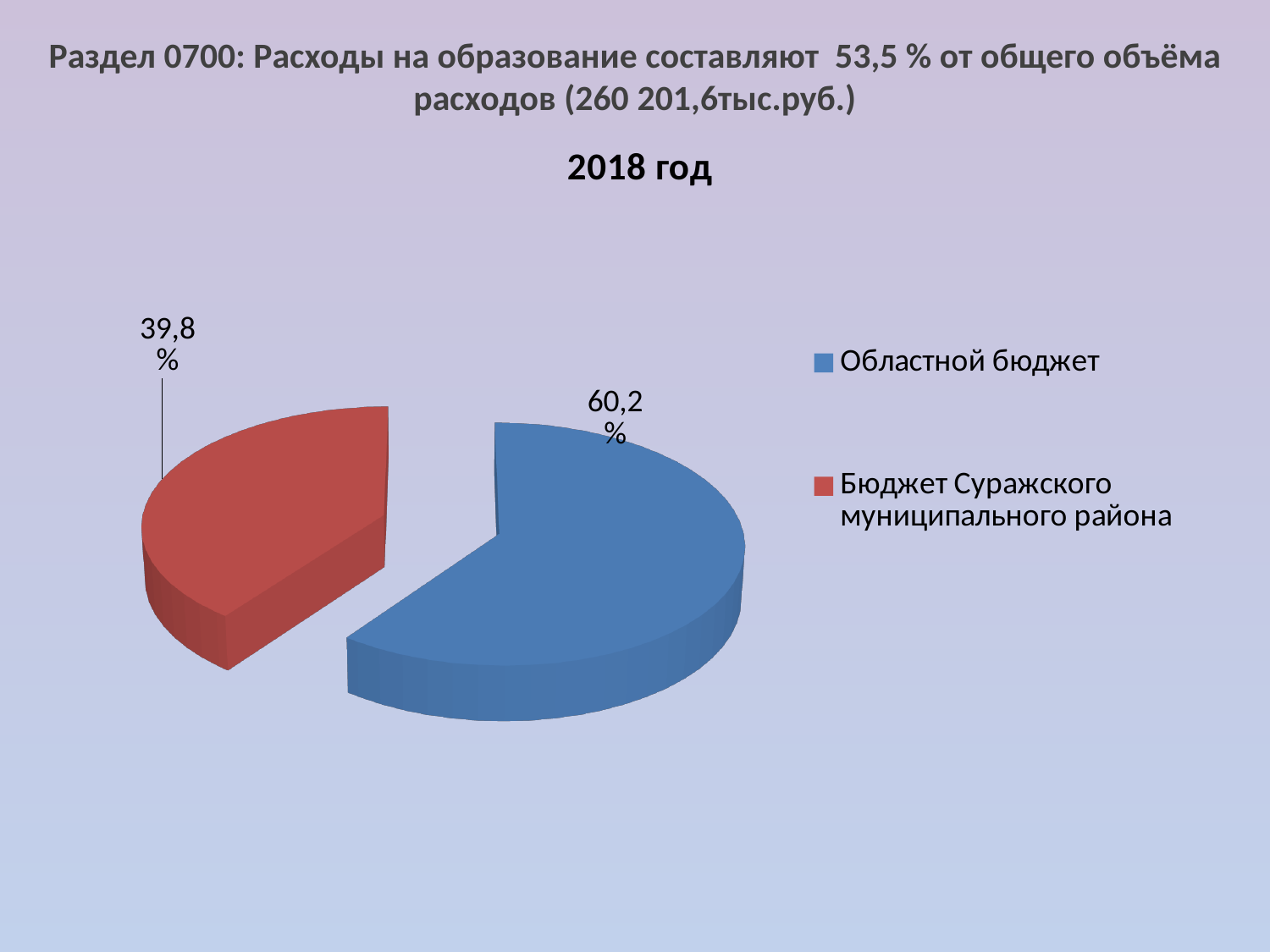
Which category has the largest share of the pie? Областной бюджет What is the title of the chart? 2018 год What colour is the slice for Бюджет Суражского муниципального района? Red Which category has the smallest share of the pie? Бюджет Суражского муниципального района How many entries does the legend list? 2 What share of the pie does Бюджет Суражского муниципального района have? 39,8% How many slices does the pie chart have? 2 What kind of chart is shown on the slide? Pie chart What is the difference in percentage points between the share of Областной бюджет and the share of Бюджет Суражского муниципального района? 20,4 Which is larger: the share of Областной бюджет or the share of Бюджет Суражского муниципального района? Областной бюджет What share of the pie does Областной бюджет have? 60,2%